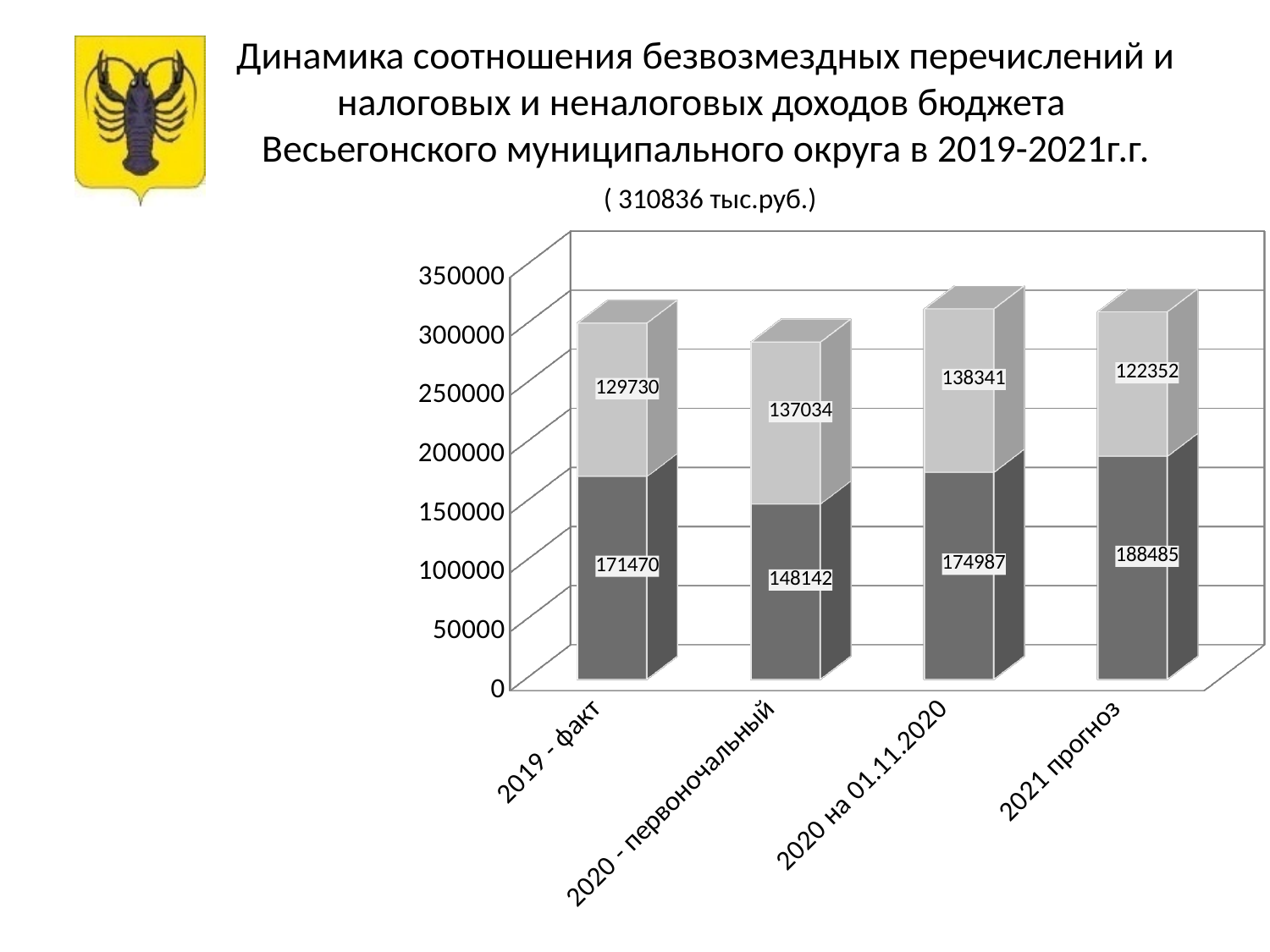
What is the value of the light upper segment for "2020 на 01.11.2020"? 138341 What value in thousand rubles is given in the subtitle below the chart title? 310836 тыс.руб. Which category has the lowest value in the light upper segment? 2021 прогноз What is the total of the stacked bar for "2019 - факт"? 301200 Which is larger: the light upper segment for "2019 - факт" or for "2020 на 01.11.2020"? 2020 на 01.11.2020 What is the value of the dark lower segment for "2019 - факт"? 171470 How many categories are shown on the x axis of the chart? 4 What is the value of the light upper segment for "2020 - первоночальный"? 137034 Which category has the highest value in the dark lower segment? 2021 прогноз What type of chart is shown on the slide? stacked bar chart What is the value of the dark lower segment for "2021 прогноз"? 188485 What is the difference between the dark lower segment values for "2021 прогноз" and "2020 - первоночальный"? 40343